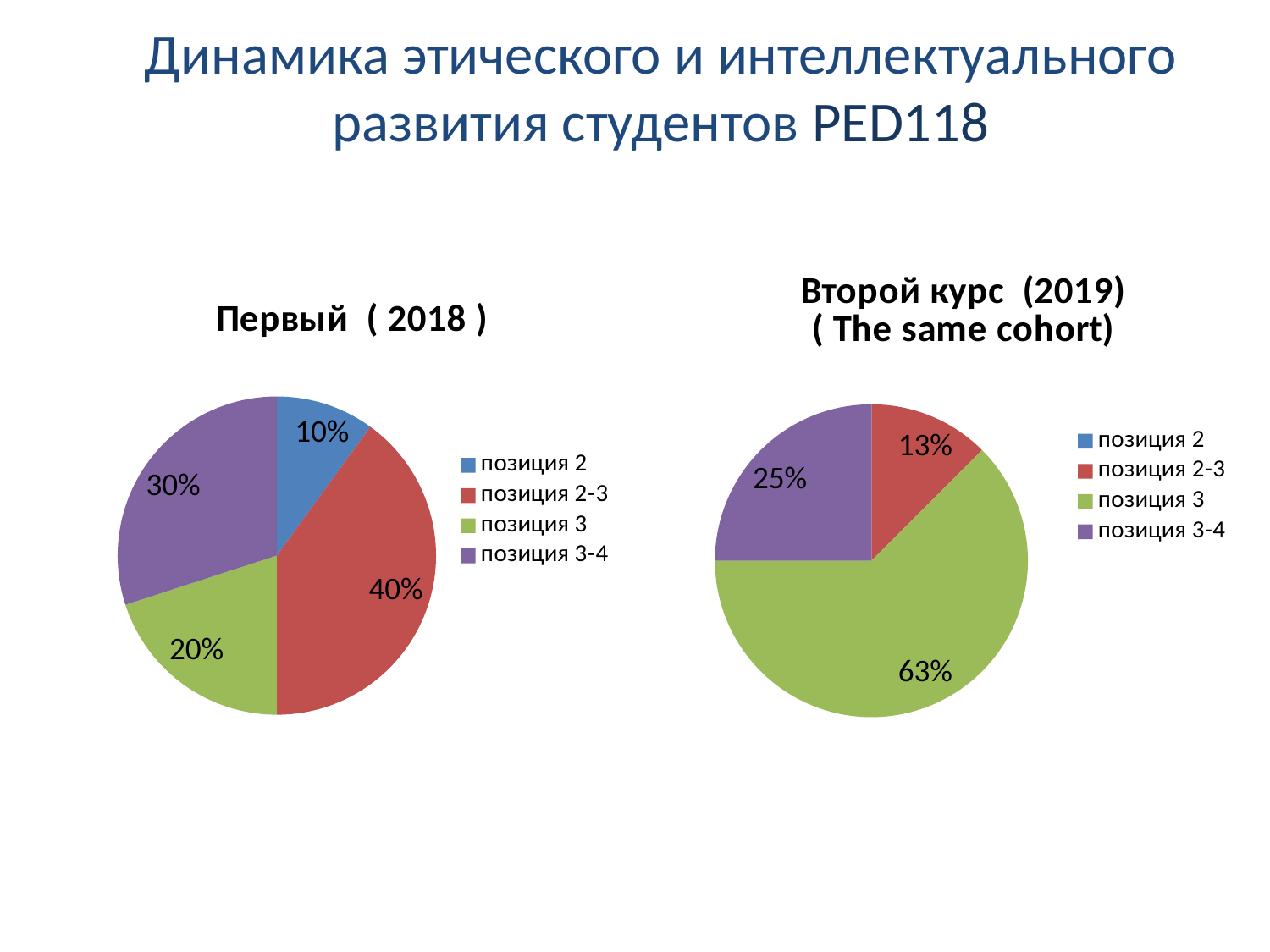
In the chart titled "Второй курс (2019)", what share does позиция 2-3 have? 13% In the chart titled "Первый ( 2018 )", what share does позиция 3-4 have? 30% In the chart titled "Второй курс (2019)", which category has the largest slice? позиция 3 What kind of chart is the chart titled "Первый ( 2018 )"? Pie chart In the chart titled "Первый ( 2018 )", which category has the smallest slice? позиция 2 In the chart titled "Второй курс (2019)", what share does позиция 3 have? 63% In the chart titled "Первый ( 2018 )", which is larger: the share of позиция 3 or the share of позиция 3-4? позиция 3-4 How many entries does the legend of the chart titled "Второй курс (2019)" list? 4 In the chart titled "Второй курс (2019)", what is the difference between the shares of позиция 3 and позиция 3-4? 38% In the chart titled "Первый ( 2018 )", which category has the largest slice? позиция 2-3 In the chart titled "Первый ( 2018 )", what share does позиция 2 have? 10% In the chart titled "Первый ( 2018 )", what share does позиция 2-3 have? 40%